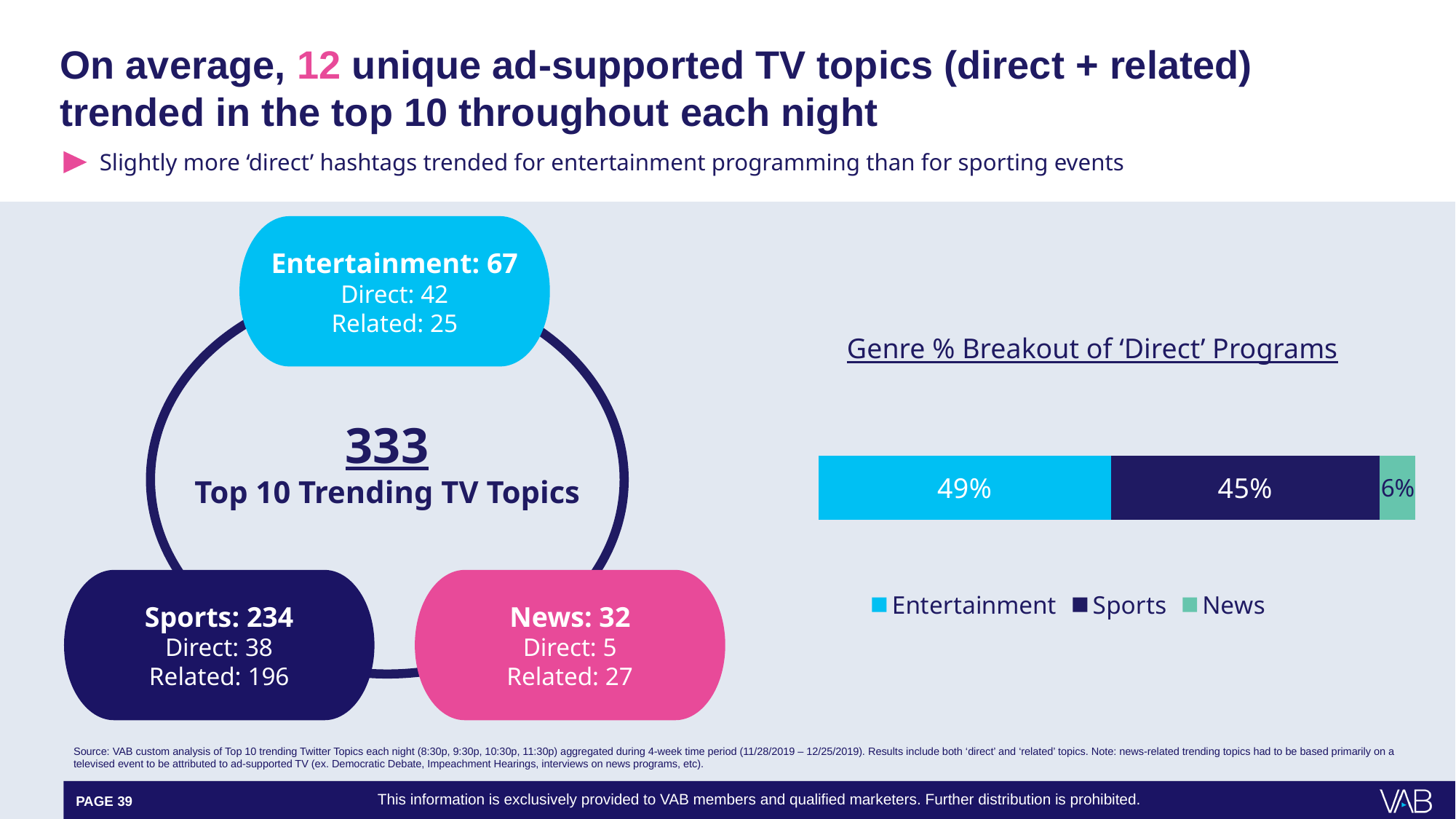
In the 'Genre % Breakout of 'Direct' Programs' chart, what is the total of the three segments in the stacked bar? 100% In the 'Genre % Breakout of 'Direct' Programs' chart, what percentage is shown for News? 6% In the 'Genre % Breakout of 'Direct' Programs' chart, what percentage is shown for Sports? 45% In the 'Genre % Breakout of 'Direct' Programs' chart, which genre has the smallest share? News What kind of chart is the 'Genre % Breakout of 'Direct' Programs' chart? Stacked bar chart In the 'Genre % Breakout of 'Direct' Programs' chart, what is the difference in percentage points between Sports and News? 39 In the 'Genre % Breakout of 'Direct' Programs' chart, which is larger, the share for Sports or the share for News? Sports In the 'Genre % Breakout of 'Direct' Programs' chart, what percentage is shown for Entertainment? 49% In the 'Genre % Breakout of 'Direct' Programs' chart, what is the difference in percentage points between Entertainment and Sports? 4 In the 'Genre % Breakout of 'Direct' Programs' chart, which genre has the largest share? Entertainment In the 'Genre % Breakout of 'Direct' Programs' chart, which genre is shown in the dark navy colour? Sports How many series does the legend of the 'Genre % Breakout of 'Direct' Programs' chart list? 3